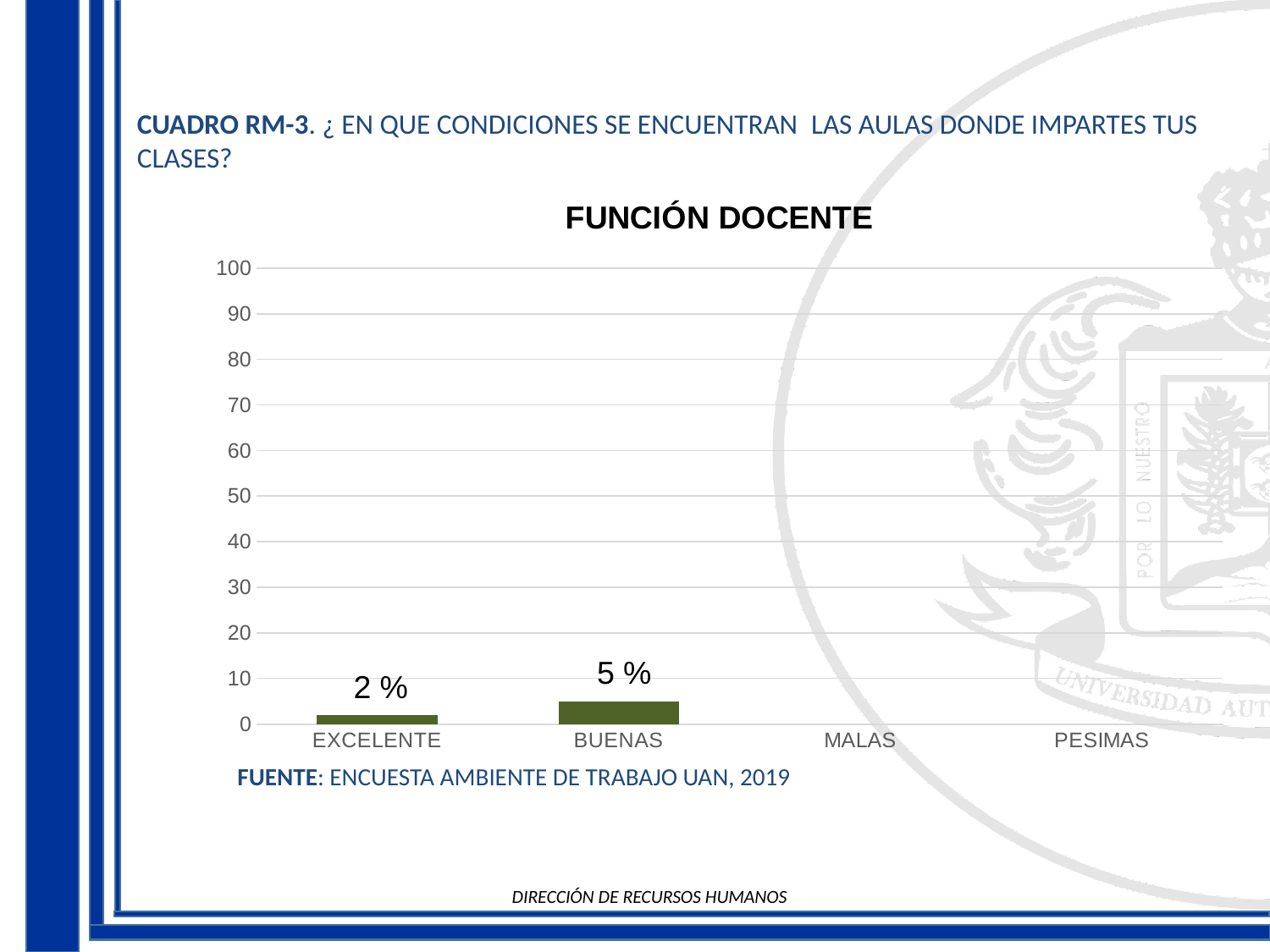
Which is larger in the FUNCIÓN DOCENTE chart, EXCELENTE or BUENAS? BUENAS What kind of chart is the FUNCIÓN DOCENTE chart? bar chart What is the difference between the values for BUENAS and EXCELENTE in the FUNCIÓN DOCENTE chart? 3 % What is the maximum value shown on the y axis of the FUNCIÓN DOCENTE chart? 100 What is the title of the chart on the slide? FUNCIÓN DOCENTE Is the value for BUENAS in the FUNCIÓN DOCENTE chart greater or less than 10? less Is the value for EXCELENTE in the FUNCIÓN DOCENTE chart greater or less than 10? less Which category has the highest value in the FUNCIÓN DOCENTE chart? BUENAS What is the value for BUENAS in the FUNCIÓN DOCENTE chart? 5 % How many categories are shown on the x axis of the FUNCIÓN DOCENTE chart? 4 What is the value for EXCELENTE in the FUNCIÓN DOCENTE chart? 2 %